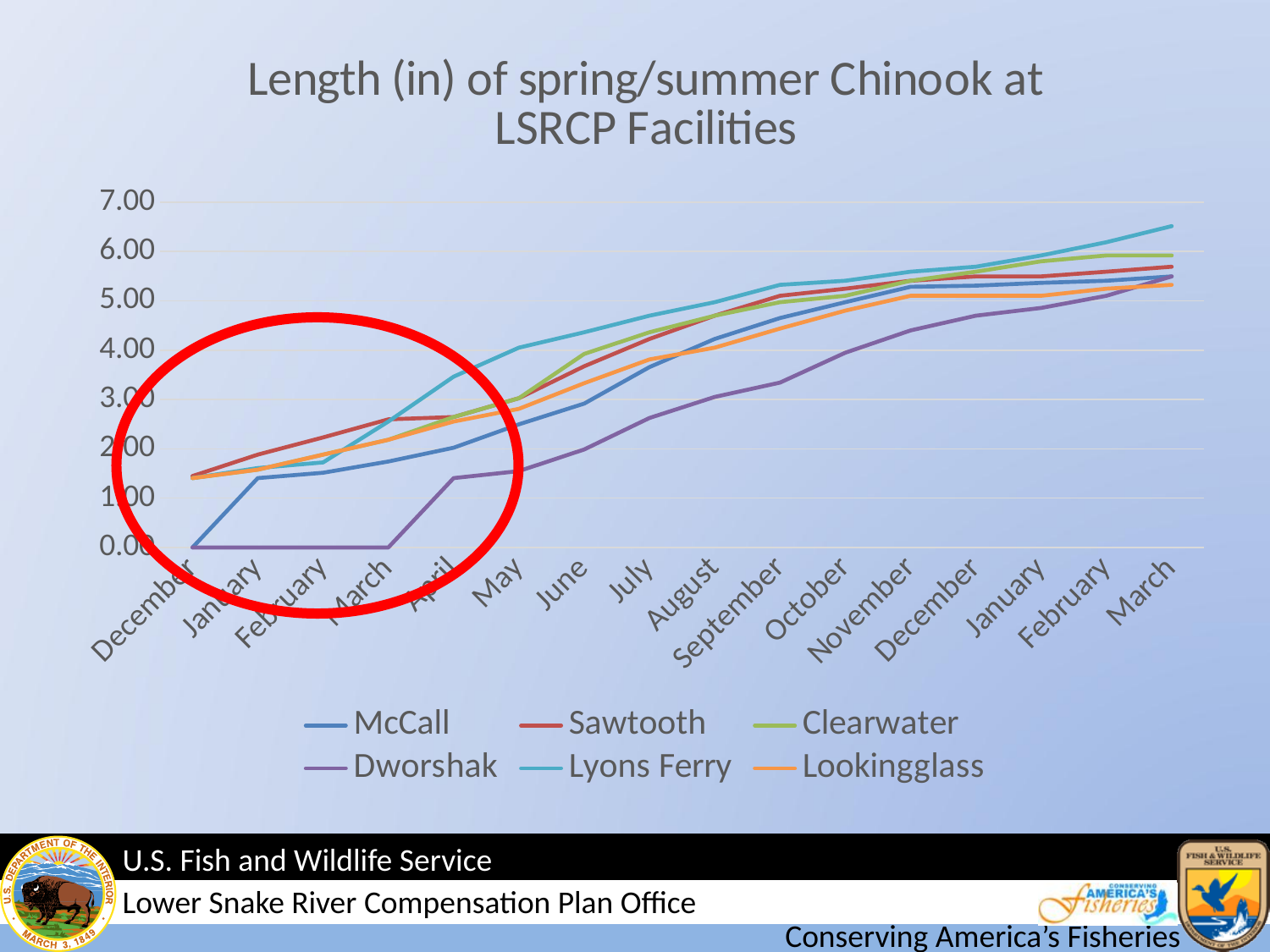
Is the value for Lyons Ferry in the final March greater or less than 6.00? greater How many months are shown along the x axis? 16 What is the value for Dworshak in February (the first February)? 0.00 Is the value for Dworshak in September greater or less than 4.00? less In April, which is larger: the value for Lyons Ferry or the value for McCall? Lyons Ferry What is the value for McCall in the first December? 0.00 Which facility has the lowest length in September? Dworshak Which facility has the highest length in the final March? Lyons Ferry What is the title of the chart? Length (in) of spring/summer Chinook at LSRCP Facilities How many series does the legend list? 6 What kind of chart is shown on the slide? line chart Do the lengths generally rise or fall from the first December to the final March? rise